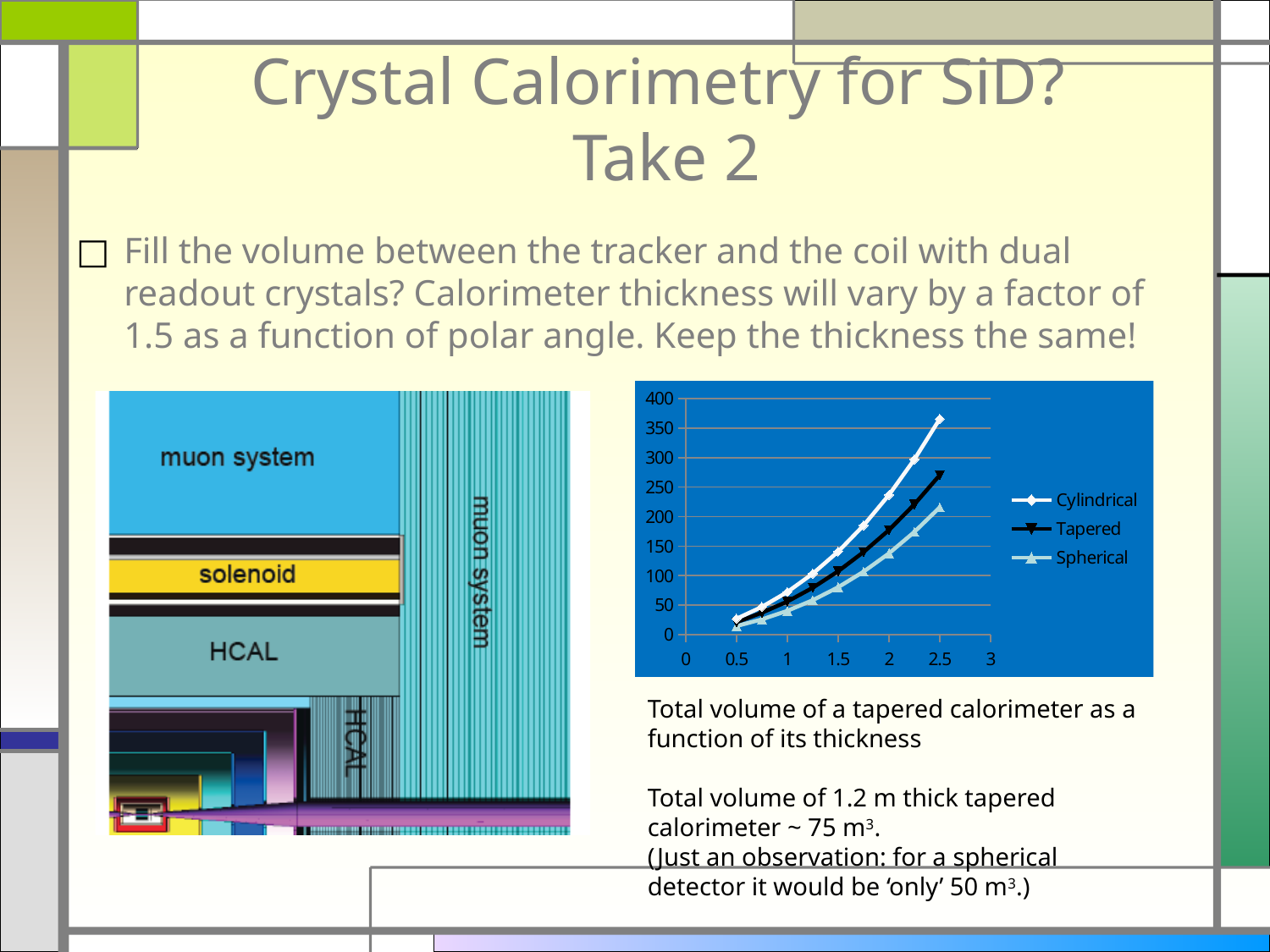
Which series are listed in the chart's legend? Cylindrical, Tapered, Spherical Do the values of the Tapered series rise or fall as x increases? rise How many series does the chart's legend list? 3 Is the value of the Cylindrical series at x = 2.5 greater or less than 350? greater Is the value of the Spherical series at x = 1 greater or less than 50? less Which series has the lowest value at x = 2.5? Spherical What is the highest value shown on the chart's y axis? 400 Which series has the highest value at x = 2.5? Cylindrical Is the value of the Cylindrical series at x = 2 greater or less than 200? greater What kind of chart is shown on the slide? line chart At x = 2, which is larger: the Tapered value or the Spherical value? Tapered